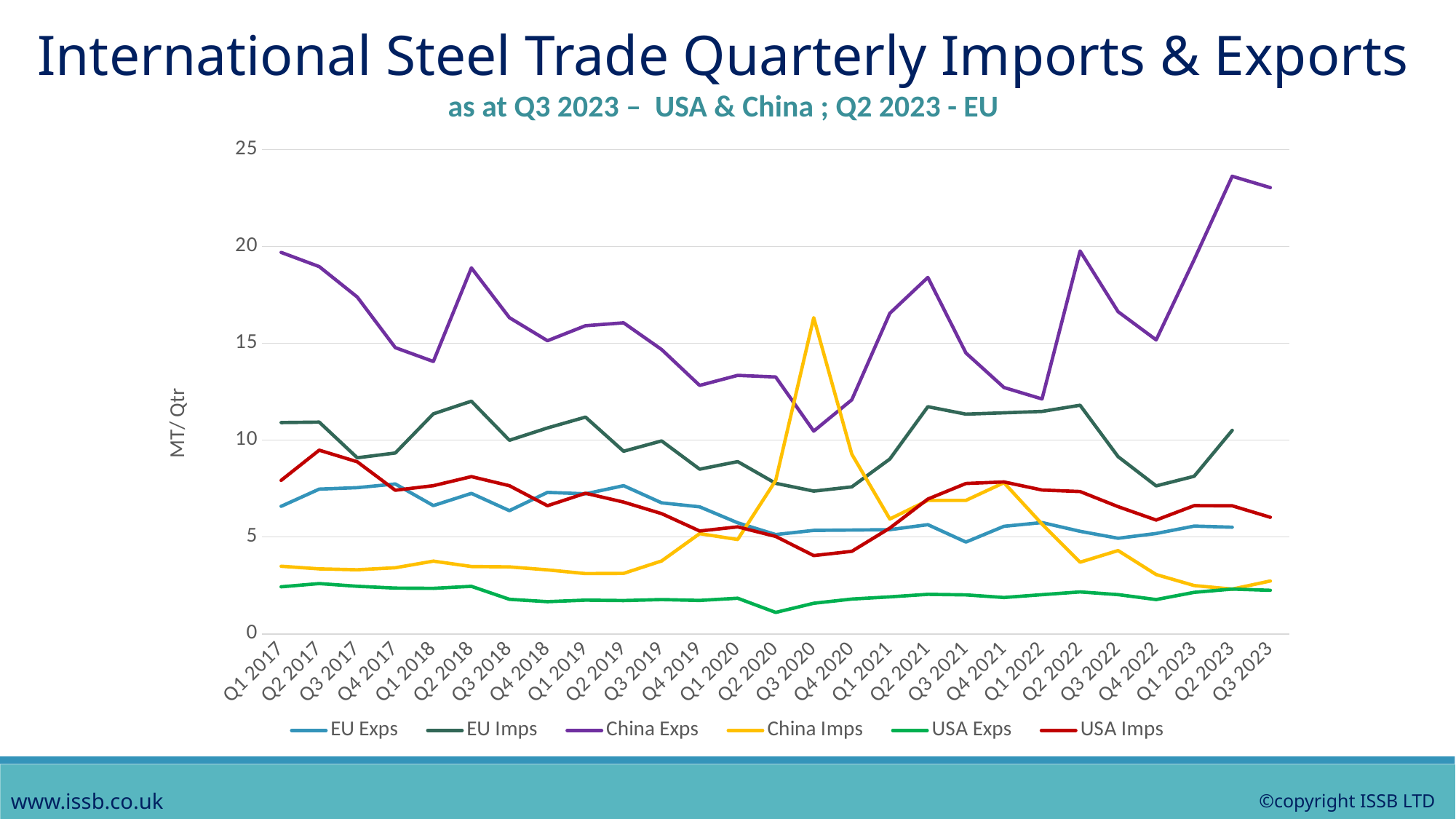
What is the label on the y axis? MT/ Qtr In Q3 2020, which is higher: China Imps or China Exps? China Imps Which series has the highest value in Q1 2017? China Exps Do the China Exps values rise or fall from Q4 2022 to Q2 2023? Rise Is the value for USA Exps in Q2 2020 greater or less than 5? less Is the value for China Exps in Q2 2023 greater or less than 20? greater How many quarters are plotted along the x axis? 27 Is the value for EU Imps in Q2 2018 greater or less than 10? greater How many series does the legend list? 6 What kind of chart is shown on the slide? Line chart Which series has the lowest value in Q3 2023? USA Exps